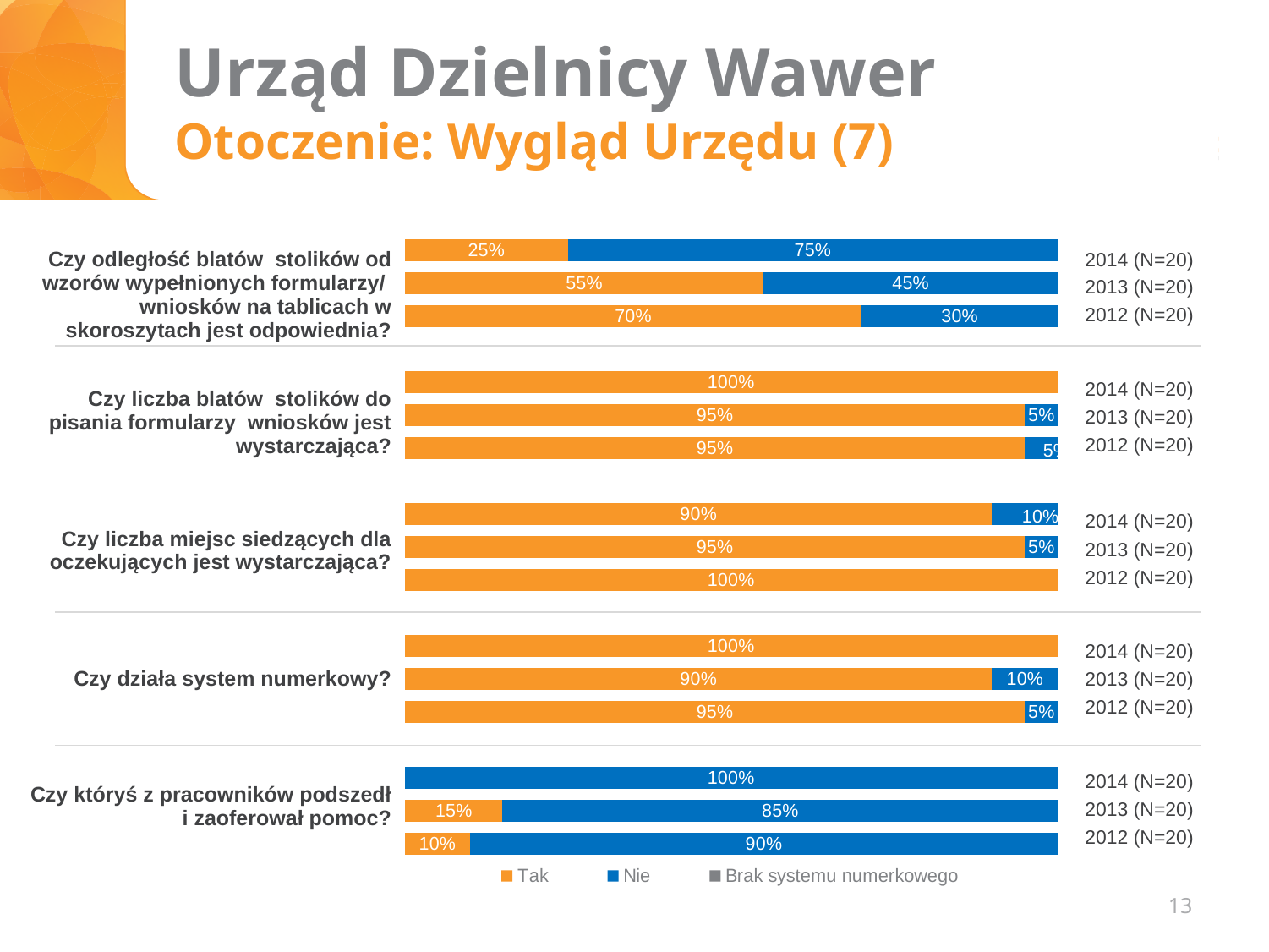
In the chart for "Czy odległość blatów stolików od wzorów wypełnionych formularzy/ wniosków na tablicach w skoroszytach jest odpowiednia?", what is the "Tak" value for 2014 (N=20)? 25% In the chart for "Czy liczba blatów stolików do pisania formularzy wniosków jest wystarczająca?", what is the "Tak" value for 2014 (N=20)? 100% What kind of chart is used on this slide? stacked bar chart In the chart for "Czy liczba miejsc siedzących dla oczekujących jest wystarczająca?", does the "Tak" share rise or fall from 2012 to 2014? fall How many series does the legend list? 3 In the chart for "Czy któryś z pracowników podszedł i zaoferował pomoc?", what is the "Nie" value for 2014 (N=20)? 100% In the chart for "Czy odległość blatów stolików od wzorów wypełnionych formularzy/ wniosków na tablicach w skoroszytach jest odpowiednia?", what is the difference between the "Nie" values for 2014 and 2013? 30% In the chart for "Czy liczba miejsc siedzących dla oczekujących jest wystarczająca?", what is the "Nie" value for 2014 (N=20)? 10% In the chart for "Czy odległość blatów stolików od wzorów wypełnionych formularzy/ wniosków na tablicach w skoroszytach jest odpowiednia?", which year has the highest "Tak" share? 2012 (N=20) In the chart for "Czy odległość blatów stolików od wzorów wypełnionych formularzy/ wniosków na tablicach w skoroszytach jest odpowiednia?", what is the "Nie" value for 2012 (N=20)? 30% In the chart for "Czy któryś z pracowników podszedł i zaoferował pomoc?", which is larger: the "Tak" value for 2013 or the "Tak" value for 2012? 2013 In the chart for "Czy działa system numerkowy?", what is the "Tak" value for 2013 (N=20)? 90%